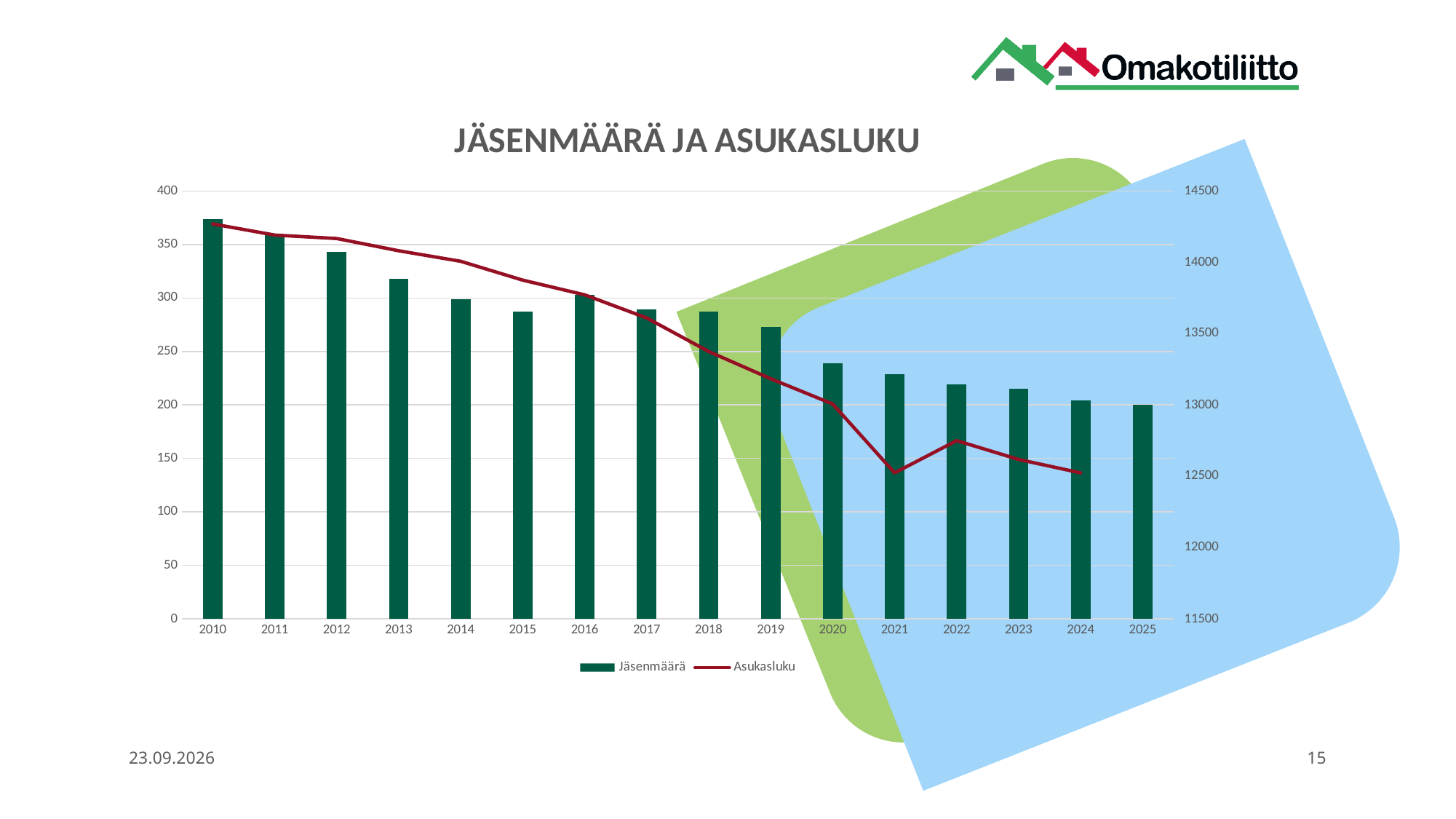
Is the Jäsenmäärä value for 2010 greater or less than 350? greater Is the Jäsenmäärä value for 2025 greater or less than 250? less Do the Jäsenmäärä bars generally rise or fall from 2010 to 2025? Fall Which year has the larger Jäsenmäärä bar, 2019 or 2020? 2019 Which year has the lowest Jäsenmäärä bar? 2025 Which year has the highest Jäsenmäärä bar? 2010 How many years are shown on the x axis? 16 What kind of chart is shown on the slide? A combined bar and line chart What is the title of the chart? JÄSENMÄÄRÄ JA ASUKASLUKU How many series does the legend list? 2 Which series is drawn as a red line? Asukasluku Is the Asukasluku value for 2021 greater or less than 13000? less